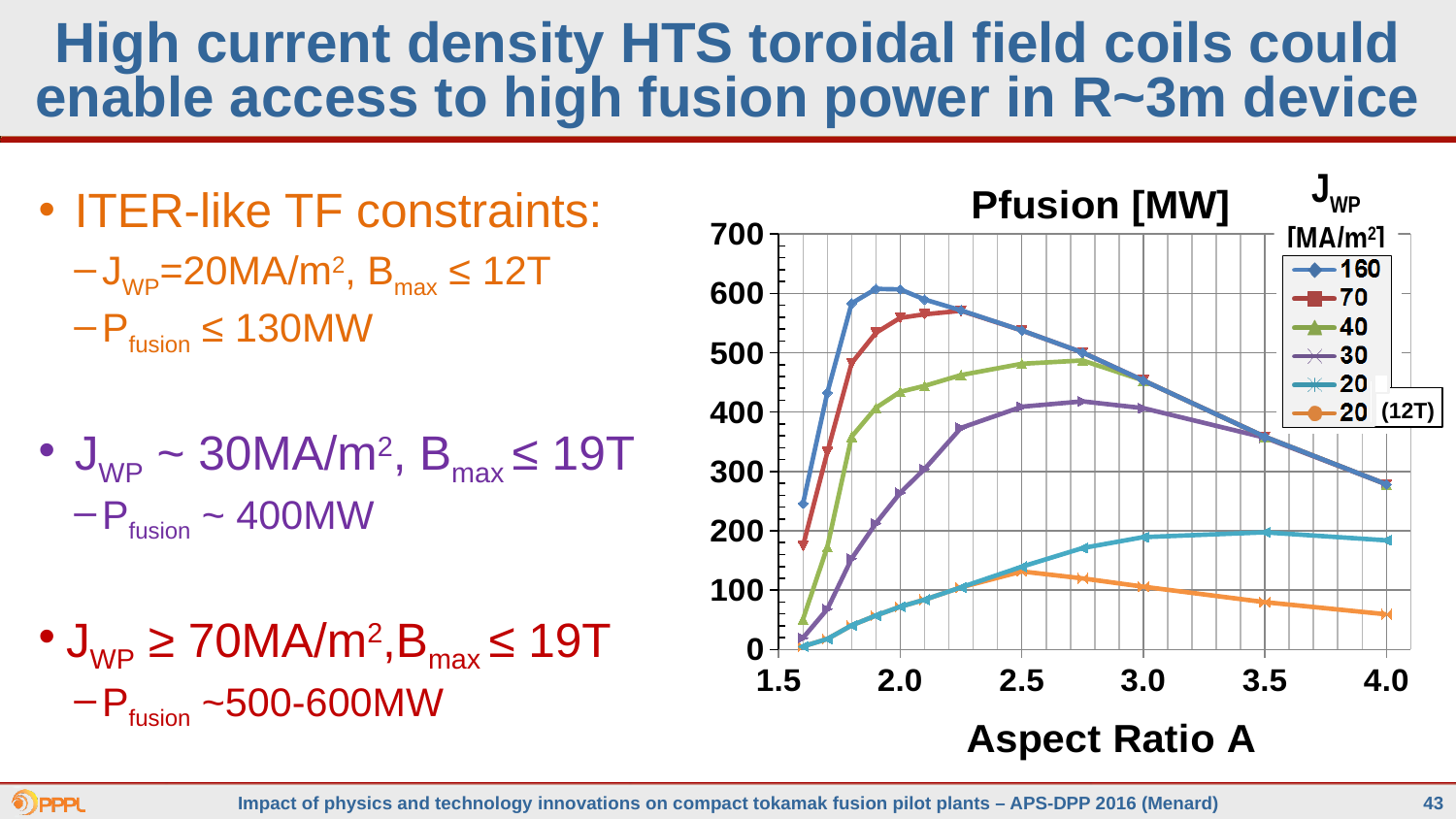
What kind of chart is shown on the slide? line chart How many series does the legend of the chart list? 6 Which series has the lowest value at aspect ratio 4.0? 20 (12T) Is the value of the 20 (12T) series at aspect ratio 4.0 greater or less than 100? less Does the 20 (12T) series rise or fall as the aspect ratio increases from 2.5 to 4.0? fall Does the 160 series rise or fall as the aspect ratio increases from 2.0 to 4.0? fall Is the value of the 40 series at aspect ratio 3.0 greater or less than 400? greater What is the title of the chart? Pfusion [MW] What is the label of the x axis of the chart? Aspect Ratio A Which series reaches the highest fusion power on the chart? 160 At aspect ratio 2.5, which series has the higher value: 160 or 30? 160 Is the value of the 160 series at aspect ratio 2.0 greater or less than 500? greater